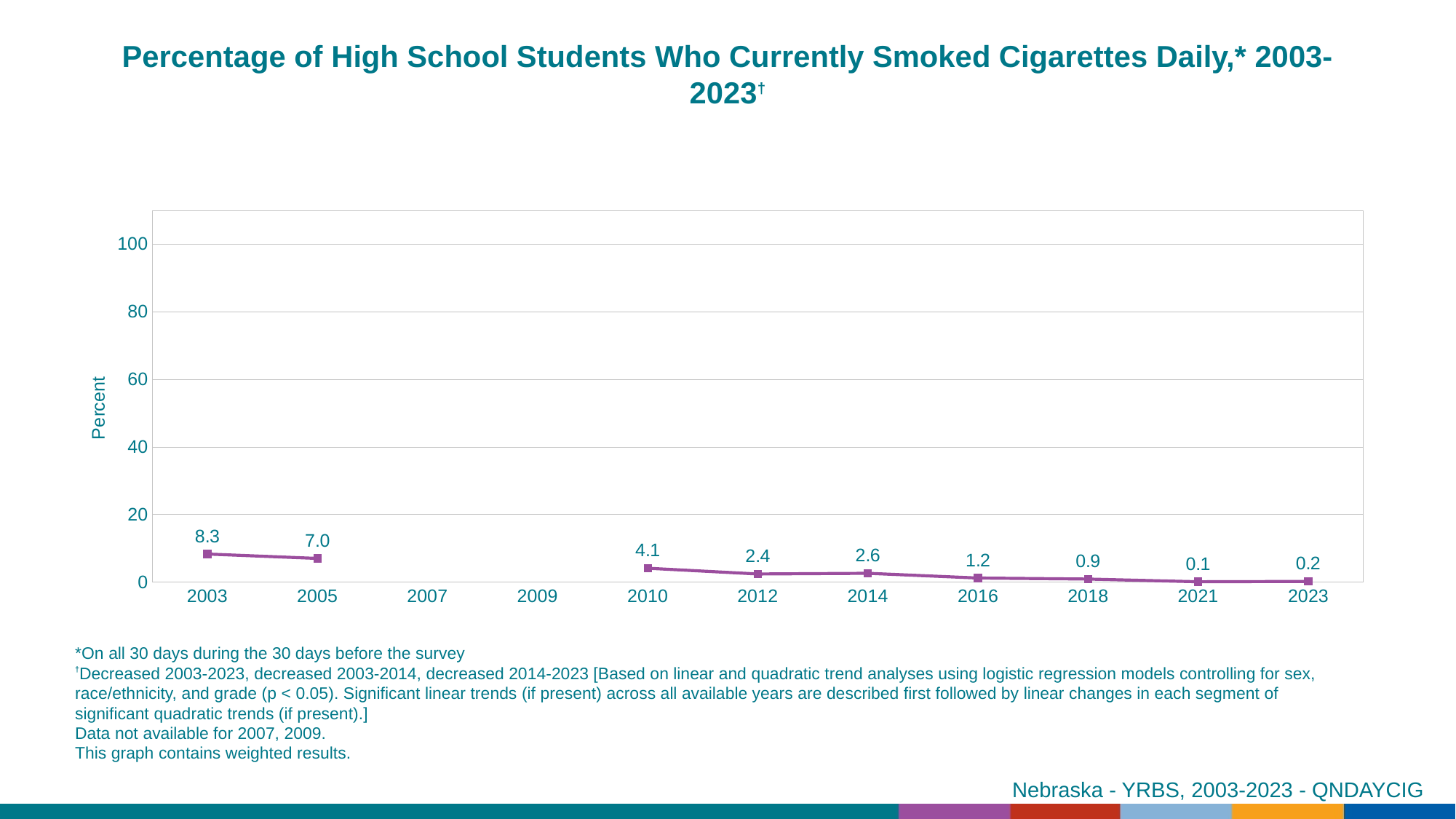
What was the percentage of high school students who currently smoked cigarettes daily in 2003? 8.3 What value is shown for 2010? 4.1 Which year has the lowest percentage? 2021 What value is shown for 2021? 0.1 Is the value for 2003 greater or less than 20? less What is the difference between the 2003 value and the 2005 value? 1.3 What value is shown for 2023? 0.2 Which is larger, the value for 2012 or the value for 2014? 2014 Which year has the highest percentage? 2003 How many years have data points plotted on the chart? 9 What kind of chart is shown? line chart Do the values generally rise or fall from 2003 to 2023? fall